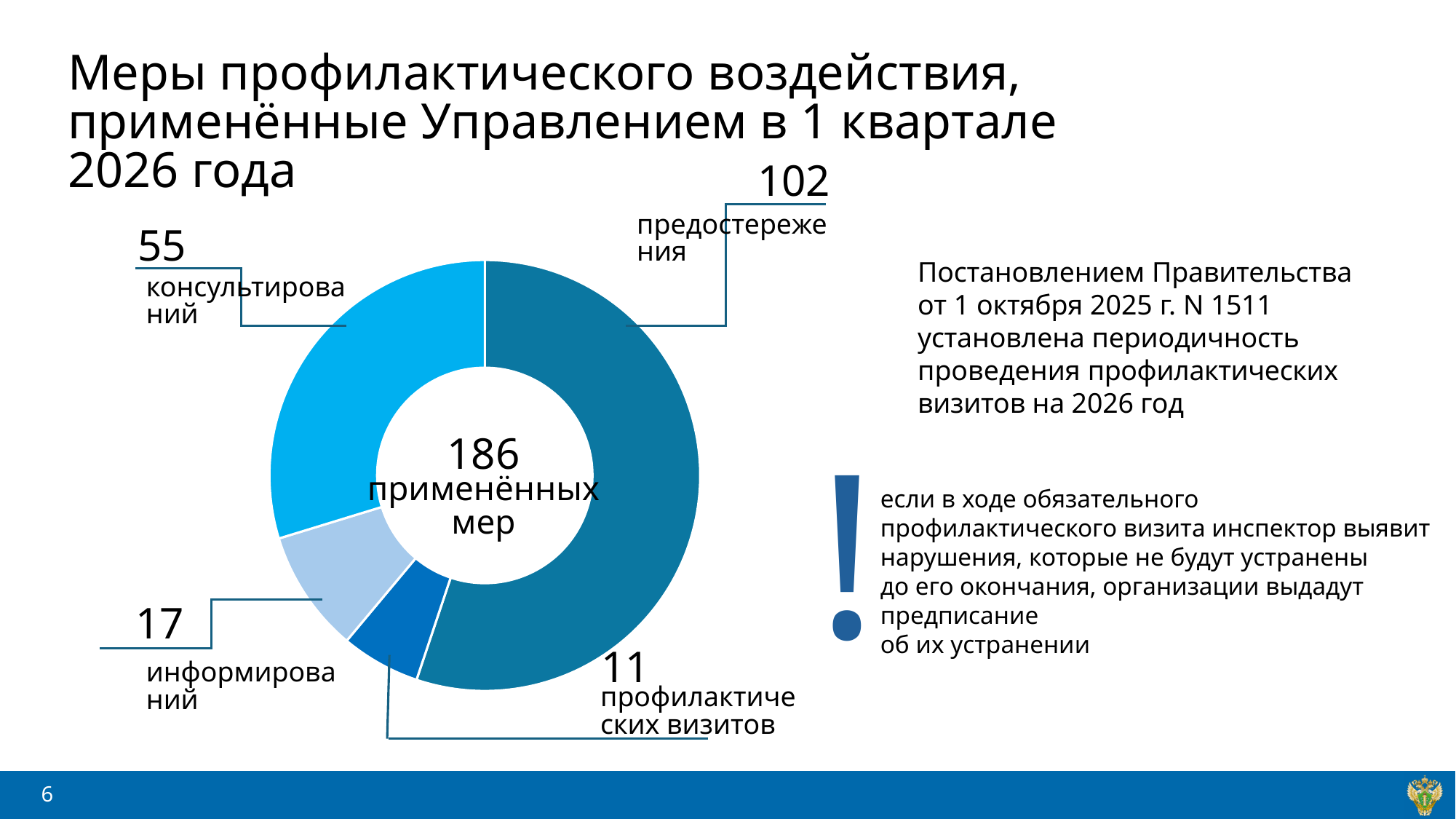
What is the difference between the values for информирований and профилактических визитов? 6 Which is larger: консультирований or информирований? консультирований What is the value for консультирований? 55 What is the value for профилактических визитов? 11 How many categories (slices) does the donut chart have? 4 What type of chart is shown on the slide? Donut (pie) chart Which category has the smallest slice in the chart? профилактических визитов What is the value for информирований? 17 What is the value for предостережения? 102 What number is printed in the centre of the donut chart? 186 Which category has the largest slice in the chart? предостережения What is the difference between the values for предостережения and консультирований? 47